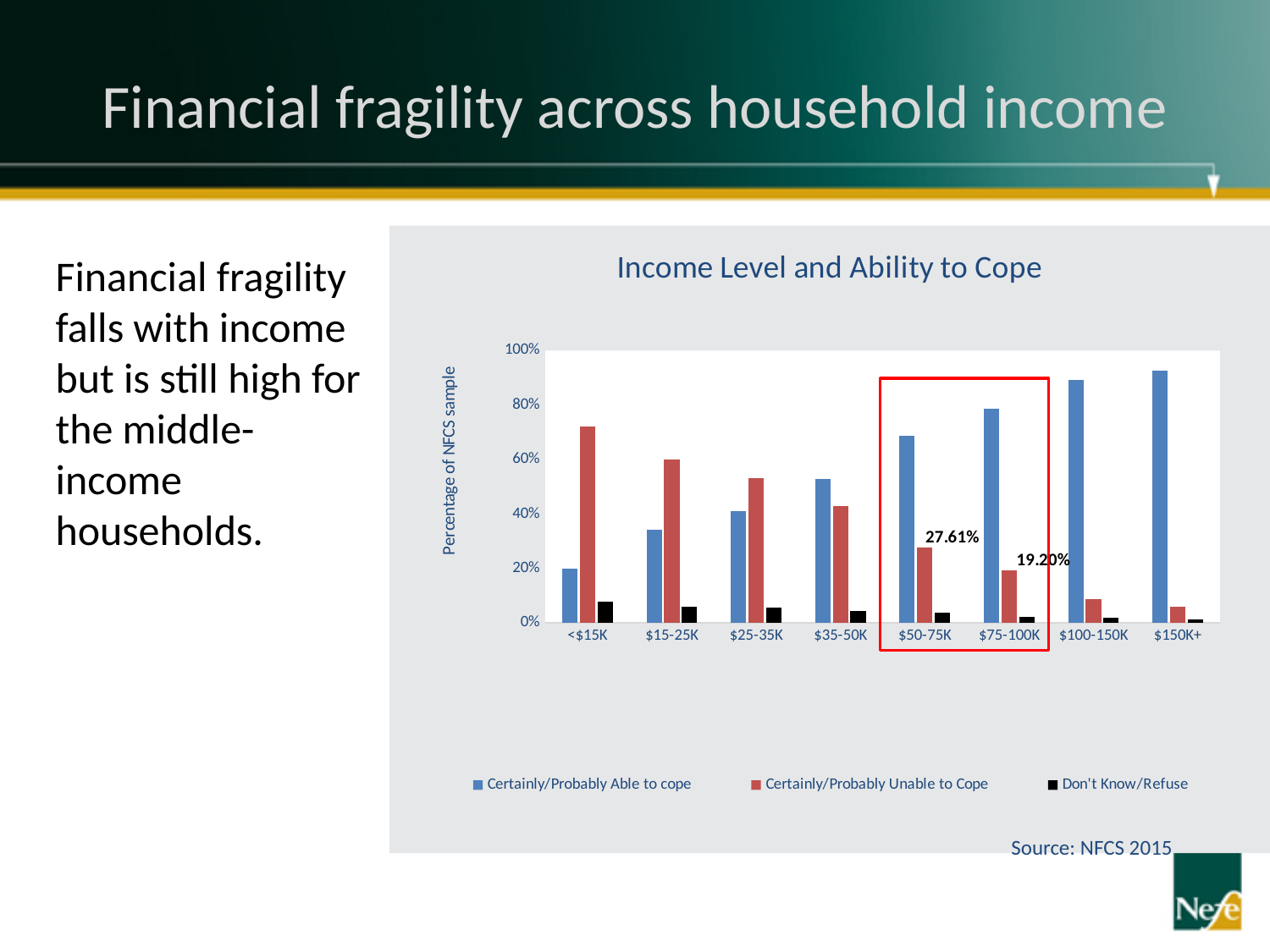
What is the value for Certainly/Probably Unable to Cope in the $50-75K income group? 27.61% Does the Certainly/Probably Unable to Cope value rise or fall as income increases along the x axis? Fall How many series does the legend list? 3 Is the value for Certainly/Probably Able to cope in the $100-150K group greater or less than 80%? greater How many income groups are shown on the x axis? 8 In the $25-35K income group, which is larger: Certainly/Probably Able to cope or Certainly/Probably Unable to Cope? Certainly/Probably Unable to Cope Is the value for Certainly/Probably Unable to Cope in the $15-25K group greater or less than 40%? greater What is the value for Certainly/Probably Unable to Cope in the $75-100K income group? 19.20% What is the difference between the Certainly/Probably Unable to Cope values for $50-75K and $75-100K? 8.41% What kind of chart is shown on the slide? Bar chart Which income group has the highest value for Certainly/Probably Unable to Cope? <$15K Which income group has the lowest value for Certainly/Probably Able to cope? <$15K